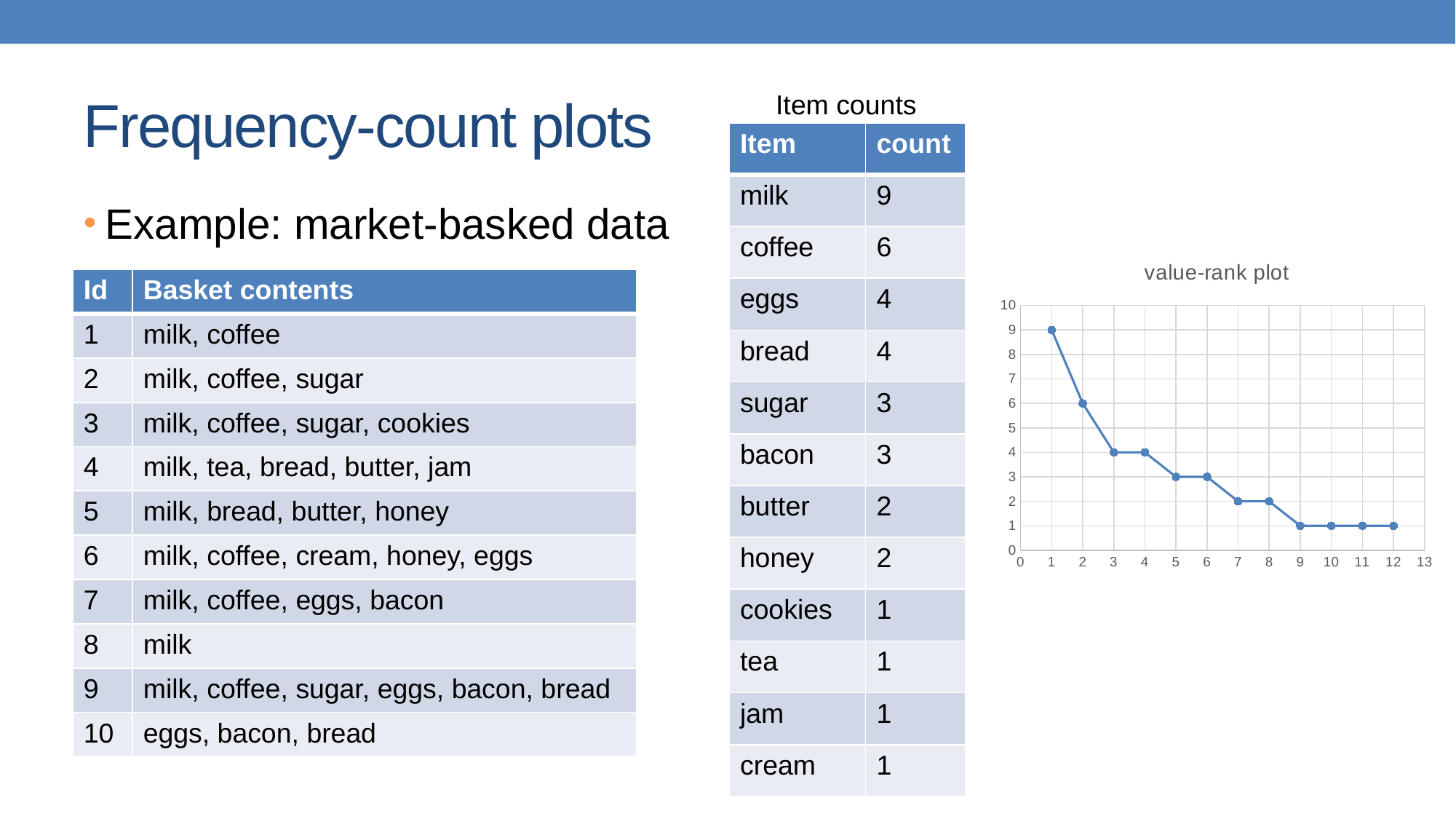
In the value-rank plot, do the values rise or fall as rank increases? fall In the value-rank plot, is the value at rank 2 larger or smaller than the value at rank 7? larger In the value-rank plot, is the value at rank 3 greater or less than 5? less What is the title of the chart on the slide? value-rank plot In the value-rank plot, what is the value at rank 12? 1 In the value-rank plot, what is the value at rank 2? 6 In the value-rank plot, what is the difference between the value at rank 1 and the value at rank 2? 3 What kind of chart is the value-rank plot? line chart In the value-rank plot, what is the value at rank 1? 9 How many data points are plotted in the value-rank plot? 12 In the value-rank plot, which rank has the highest value? 1 In the value-rank plot, what is the value at rank 5? 3